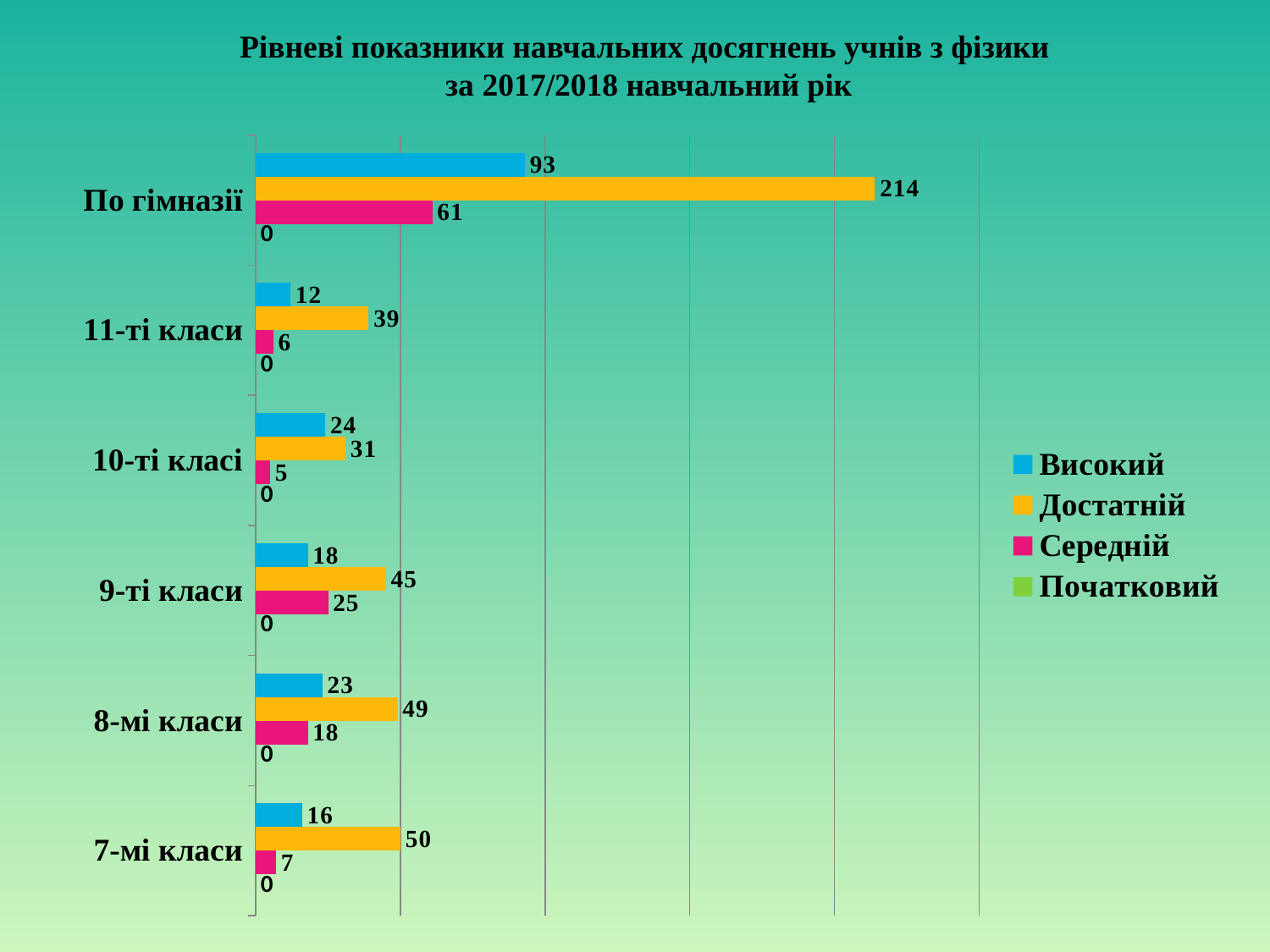
What is the value of Середній for 9-ті класи? 25 What is the value of Початковий for 7-мі класи? 0 Which is larger: the Високий value for 11-ті класи or the Високий value for 7-мі класи? 7-мі класи What is the value of Достатній for По гімназії? 214 What kind of chart is shown on the slide? Bar chart Which class category has the highest Достатній value, excluding По гімназії? 7-мі класи What is the value of Високий for 10-ті класі? 24 What colour represents the Середній series in the legend? Pink How many series does the legend list? 4 Which category has the lowest Середній value? 10-ті класі What is the difference between the Достатній and Високий values for 8-мі класи? 26 How many categories are shown on the vertical axis? 6